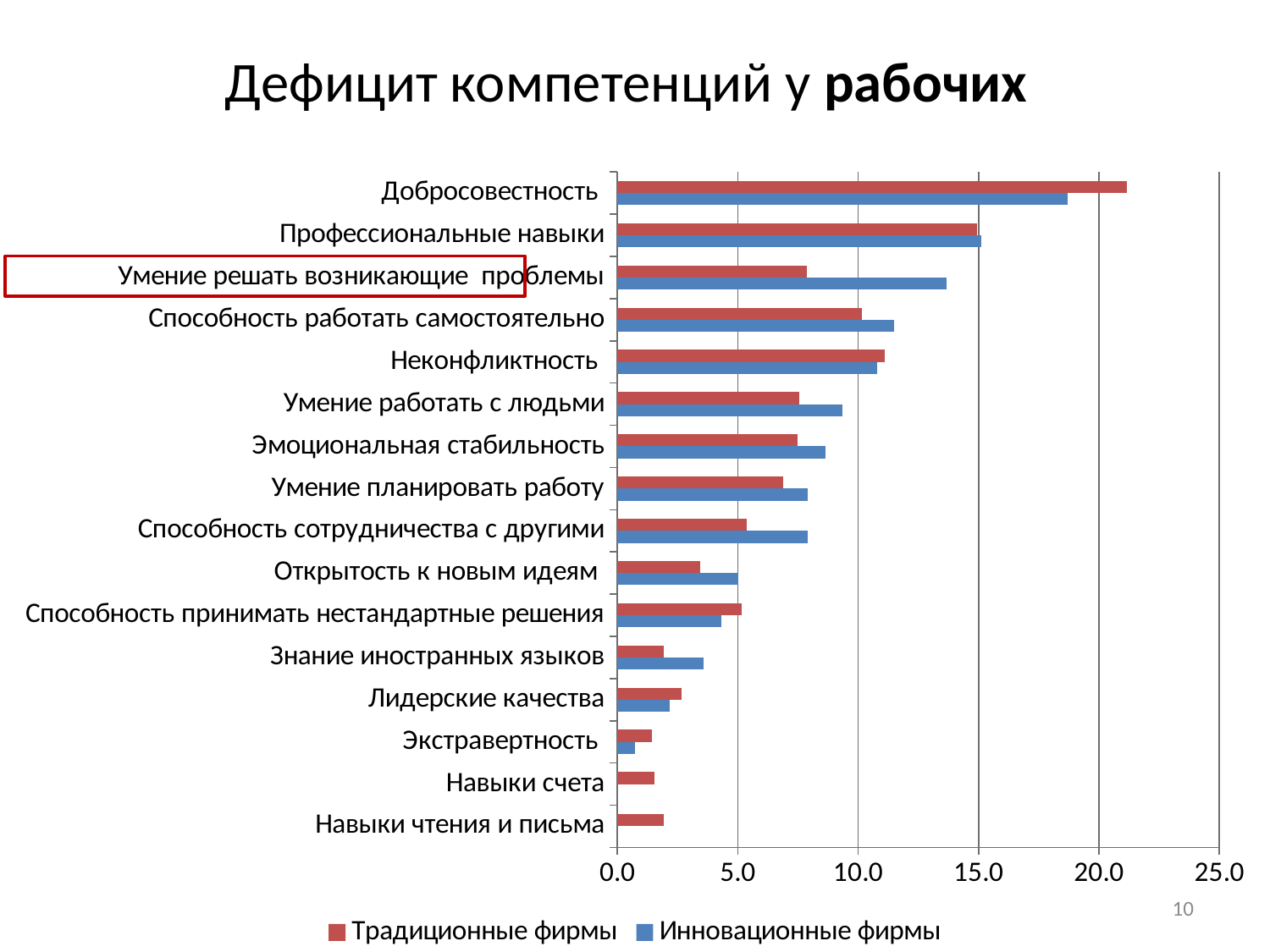
How many competency categories are shown on the chart? 16 Which category has the highest value for Традиционные фирмы? Добросовестность Is the value for Добросовестность for Традиционные фирмы greater or less than 20.0? greater For Умение решать возникающие проблемы, which series has the larger value: Традиционные фирмы or Инновационные фирмы? Инновационные фирмы Which category has the highest value for Инновационные фирмы? Добросовестность Is the value for Открытость к новым идеям for Традиционные фирмы greater or less than 5.0? less Is the value for Неконфликтность for Традиционные фирмы greater or less than 10.0? greater For Добросовестность, which series has the larger value: Традиционные фирмы or Инновационные фирмы? Традиционные фирмы How many series does the legend list? 2 What kind of chart is shown on the slide? Bar chart Which colour represents Инновационные фирмы in the chart? Blue